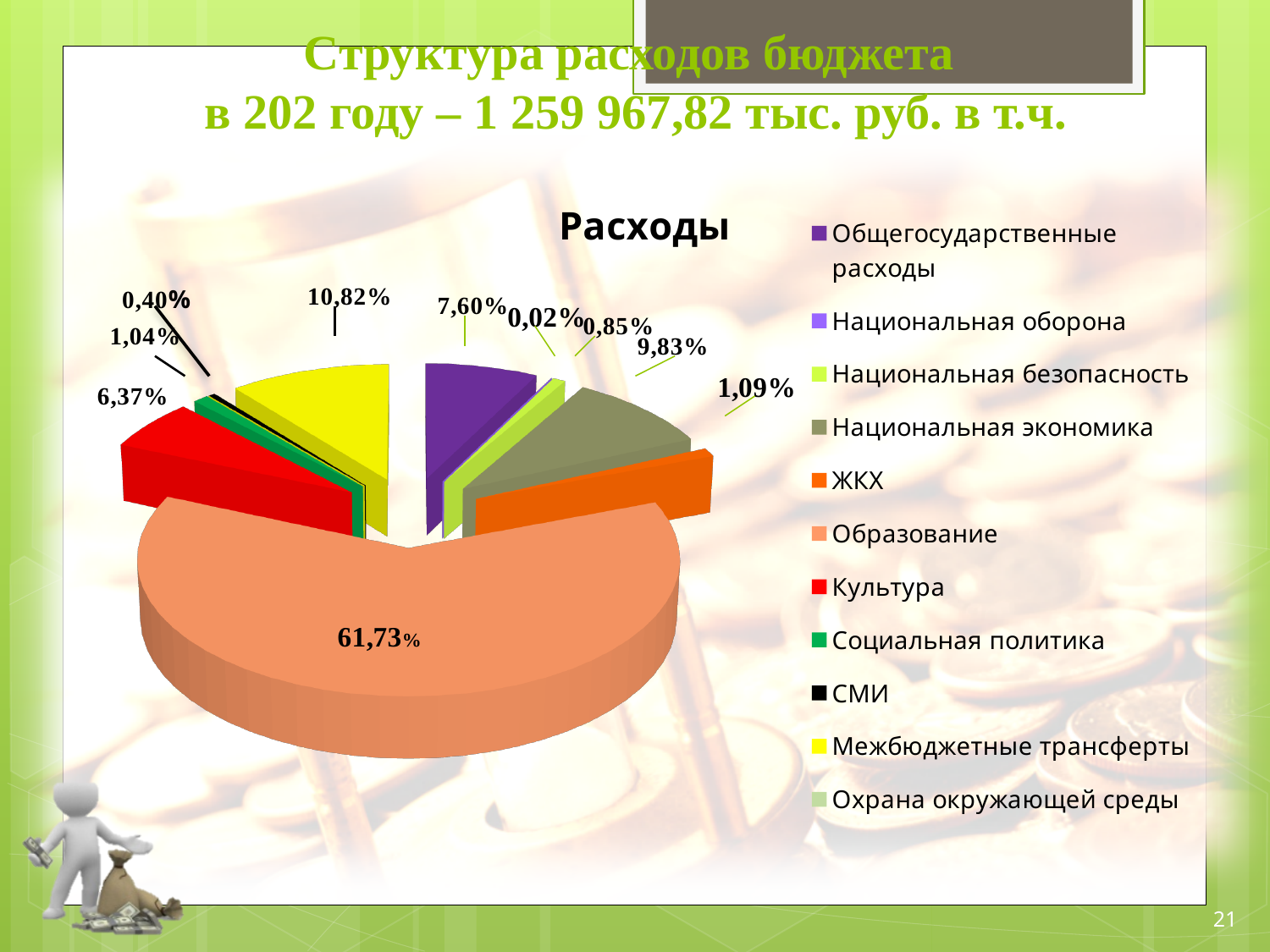
What is the title of the chart? Расходы What share of the pie does Национальная экономика have? 9,83% What share of the pie does Образование have? 61,73% Which has the larger share: Культура or Общегосударственные расходы? Общегосударственные расходы What share of the pie does Культура have? 6,37% How many categories does the legend of the chart list? 11 Which has the larger share: Межбюджетные трансферты or Национальная экономика? Межбюджетные трансферты What kind of chart is shown on the slide? Pie chart Which category has the largest share of the pie? Образование By how many percentage points does the share of Образование exceed the share of Межбюджетные трансферты? 50,91